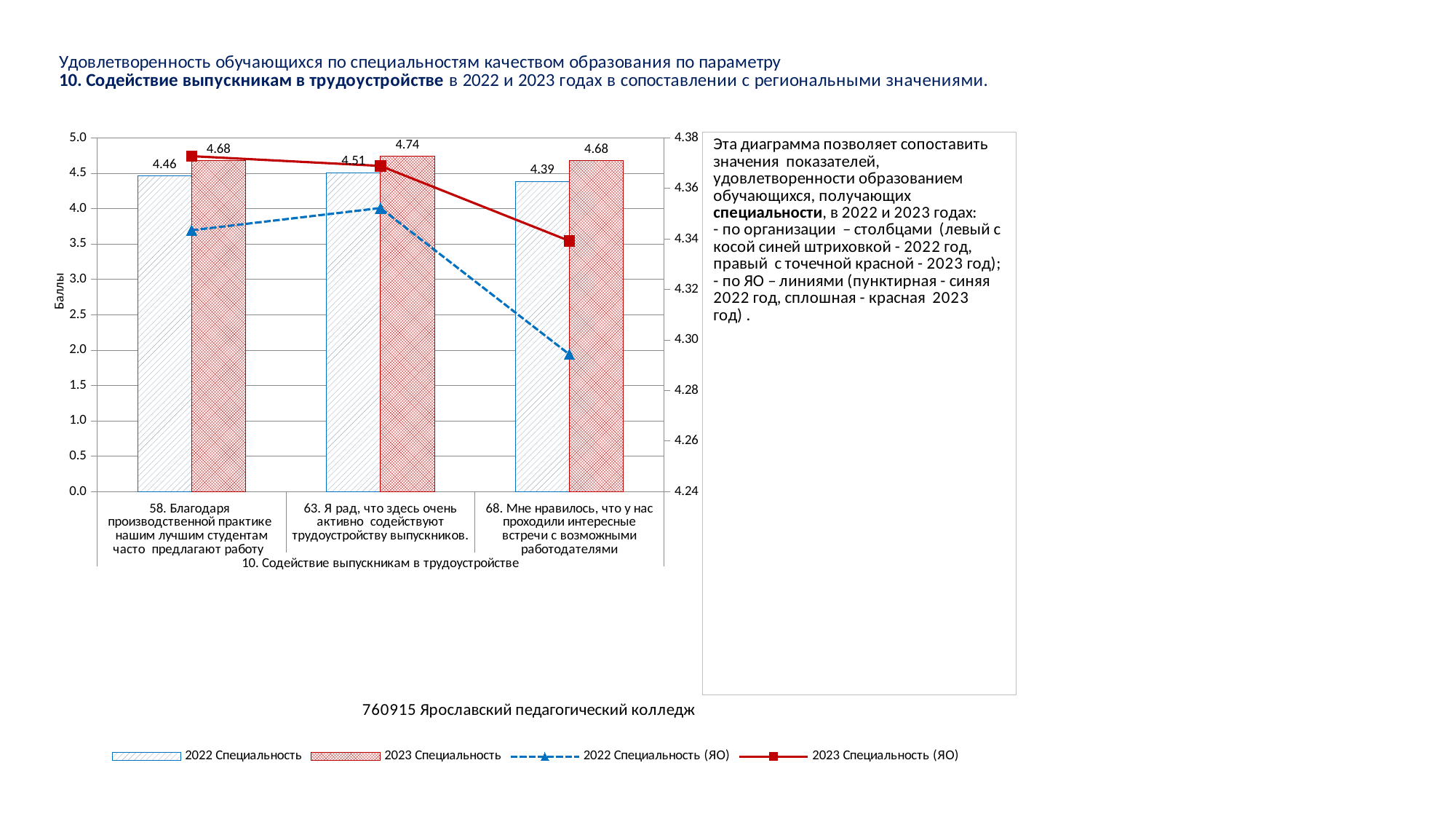
Does the solid red 2023 Специальность (ЯО) line rise or fall from left to right across the categories? fall What is the value of the 2023 Специальность bar for category 63 (Я рад, что здесь очень активно содействуют трудоустройству выпускников)? 4.74 Which is larger: the 2022 Специальность value for category 58 or for category 63? Category 63 (4.51) What is the value of the 2022 Специальность bar for category 68 (Мне нравилось, что у нас проходили интересные встречи с возможными работодателями)? 4.39 What is the value of the 2023 Специальность bar for category 68? 4.68 How many series does the legend list? 4 Which category has the lowest 2022 Специальность bar? 68. Мне нравилось, что у нас проходили интересные встречи с возможными работодателями By how much does the 2023 Специальность value exceed the 2022 Специальность value for category 63? 0.23 On the right-hand axis, is the 2023 Специальность (ЯО) line value for category 58 greater or less than 4.36? greater Which category has the highest 2023 Специальность bar? 63. Я рад, что здесь очень активно содействуют трудоустройству выпускников. How many categories are shown on the x axis of the chart? 3 What is the value of the 2022 Специальность bar for category 58 (Благодаря производственной практике нашим лучшим студентам часто предлагают работу)? 4.46